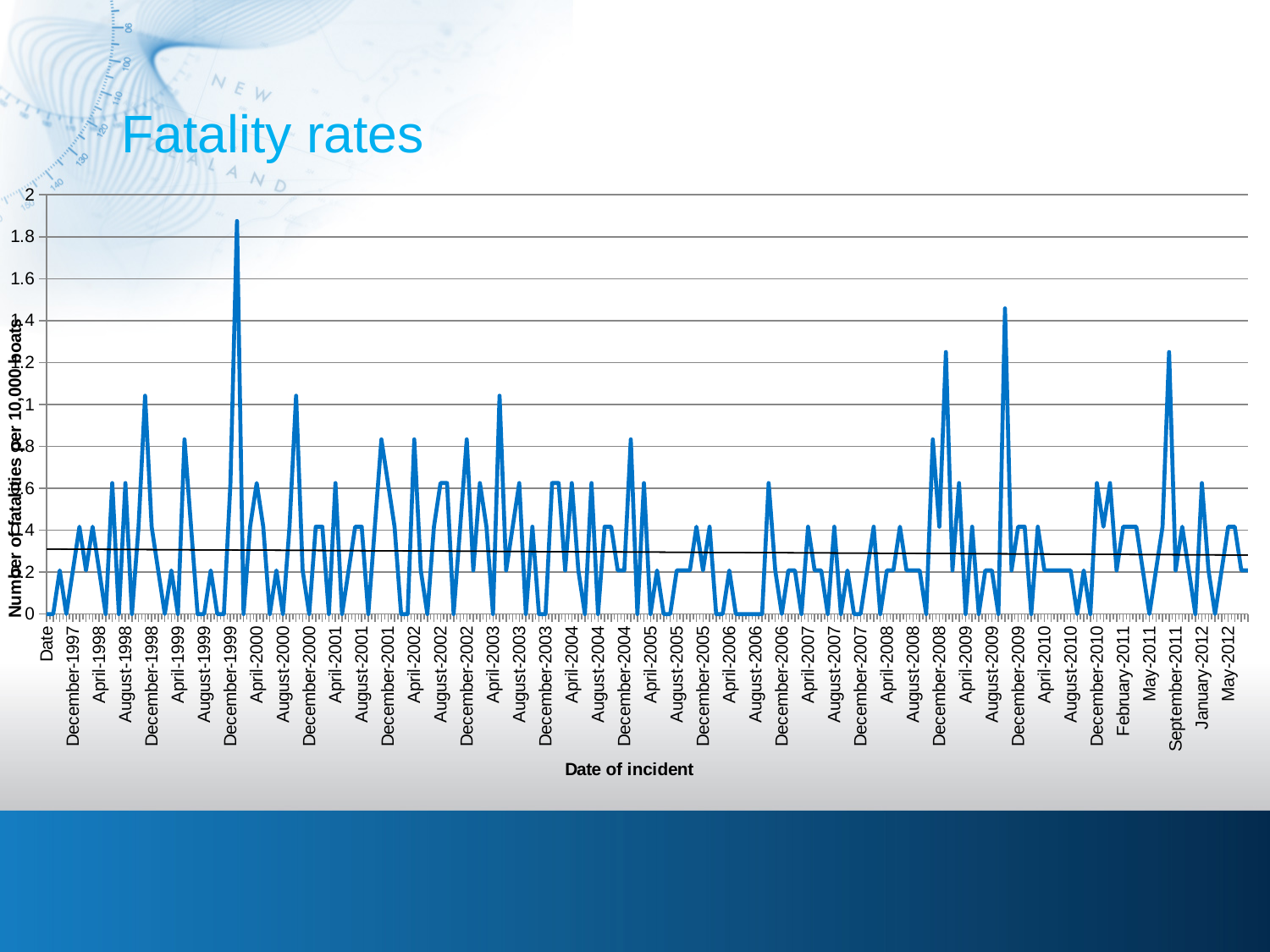
Is the highest peak of the blue line greater or less than 1.6? greater What is the title of the chart on the slide? Fatality rates Is the peak of the blue line near August-2009 greater or less than 1.6? less Is the black trend line across the chart greater or less than 0.4? less What is the label of the x axis of the chart? Date of incident What is the highest value shown on the y axis of the chart? 2 What kind of chart is shown on the slide? line chart